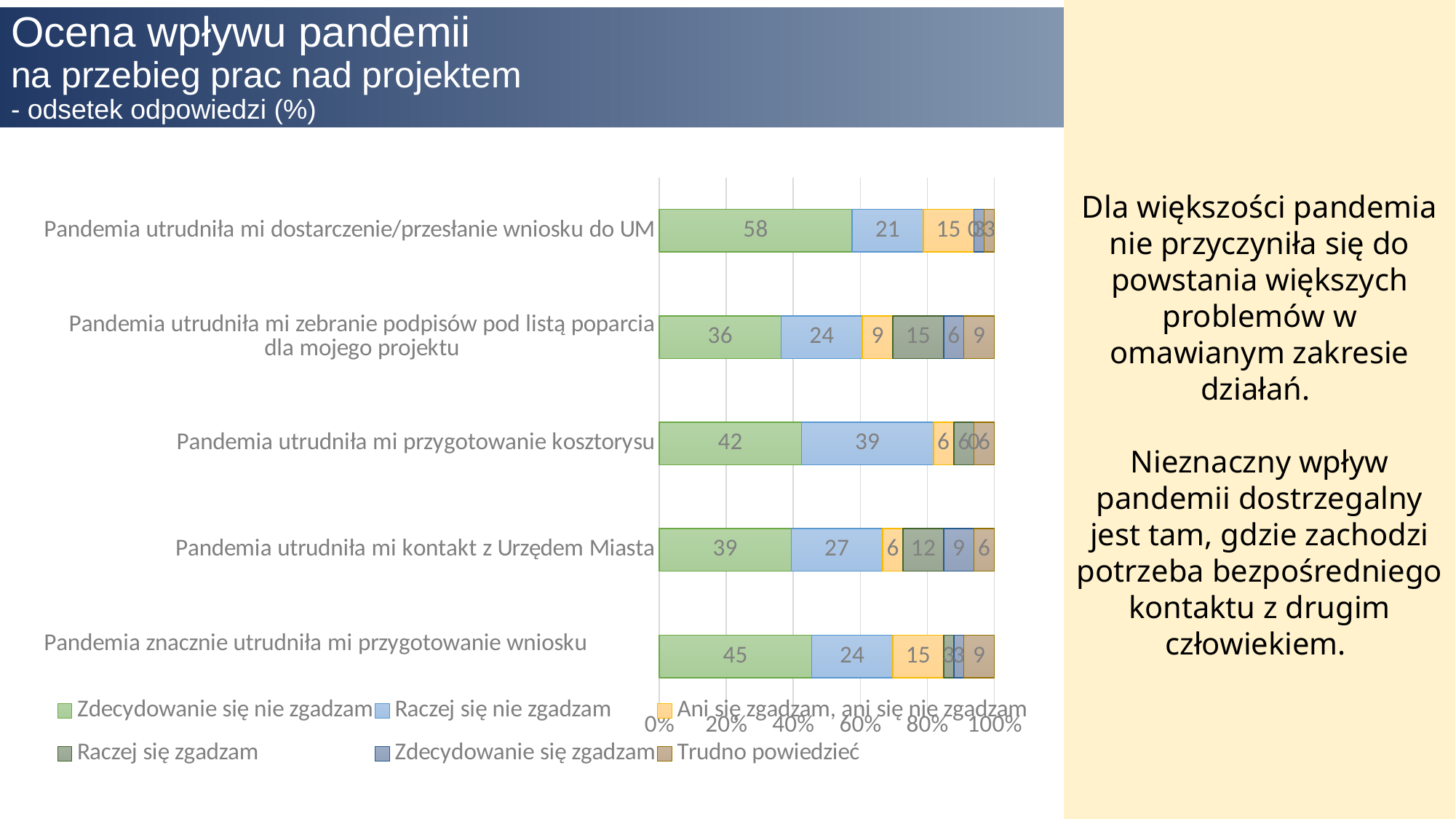
What is the value of 'Zdecydowanie się zgadzam' for 'Pandemia utrudniła mi kontakt z Urzędem Miasta'? 9 Which statement has the highest value for 'Zdecydowanie się nie zgadzam'? Pandemia utrudniła mi dostarczenie/przesłanie wniosku do UM What is the value of 'Raczej się zgadzam' for 'Pandemia utrudniła mi zebranie podpisów pod listą poparcia dla mojego projektu'? 15 What is the value of 'Trudno powiedzieć' for 'Pandemia znacznie utrudniła mi przygotowanie wniosku'? 9 How many categories (statements) are plotted on the chart? 5 Which is larger: 'Raczej się nie zgadzam' for 'Pandemia utrudniła mi kontakt z Urzędem Miasta' or for 'Pandemia znacznie utrudniła mi przygotowanie wniosku'? Pandemia utrudniła mi kontakt z Urzędem Miasta What is the value of 'Raczej się nie zgadzam' for 'Pandemia utrudniła mi przygotowanie kosztorysu'? 39 Which statement has the lowest value for 'Zdecydowanie się nie zgadzam'? Pandemia utrudniła mi zebranie podpisów pod listą poparcia dla mojego projektu How many series does the legend list? 6 What is the difference between the 'Zdecydowanie się nie zgadzam' values for 'Pandemia utrudniła mi dostarczenie/przesłanie wniosku do UM' and 'Pandemia utrudniła mi kontakt z Urzędem Miasta'? 19 What is the value of 'Zdecydowanie się nie zgadzam' for 'Pandemia utrudniła mi dostarczenie/przesłanie wniosku do UM'? 58 What kind of chart is shown on the slide? stacked bar chart